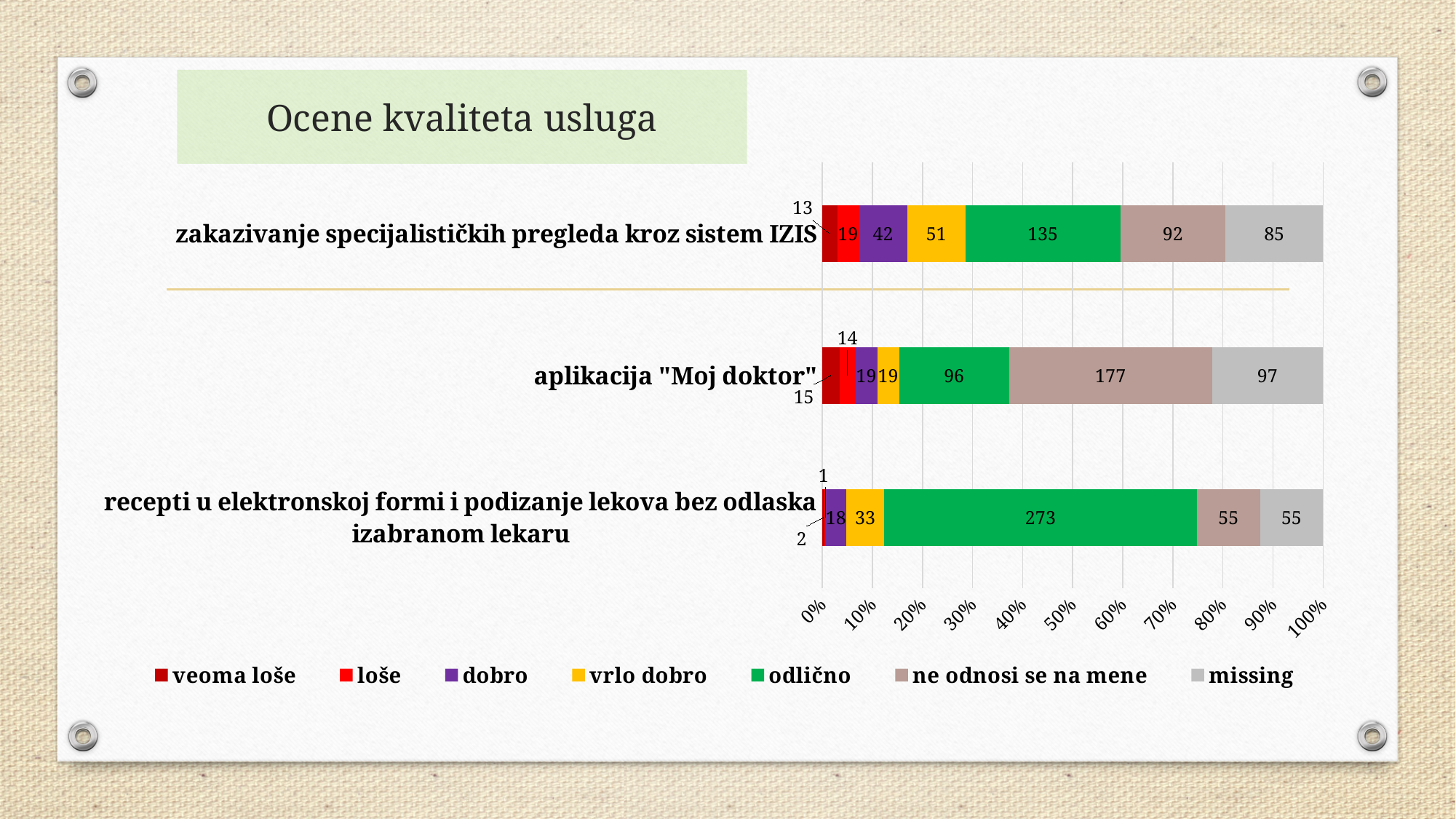
How many series does the legend list? 7 What is the difference between the "odlično" values for "zakazivanje specijalističkih pregleda kroz sistem IZIS" and "aplikacija "Moj doktor""? 39 What is the value of "vrlo dobro" for "zakazivanje specijalističkih pregleda kroz sistem IZIS"? 51 Which is larger: "ne odnosi se na mene" for "aplikacija "Moj doktor"" or for "zakazivanje specijalističkih pregleda kroz sistem IZIS"? aplikacija "Moj doktor" What kind of chart is shown on the slide? stacked bar chart Which category has the highest value for "odlično"? recepti u elektronskoj formi i podizanje lekova bez odlaska izabranom lekaru How many categories (bars) are shown in the chart? 3 What is the value of "ne odnosi se na mene" for "aplikacija "Moj doktor""? 177 What is the value of "missing" for "aplikacija "Moj doktor""? 97 Which category has the lowest value for "dobro"? recepti u elektronskoj formi i podizanje lekova bez odlaska izabranom lekaru What is the value of "odlično" for "recepti u elektronskoj formi i podizanje lekova bez odlaska izabranom lekaru"? 273 What is the total of all segments in the bar for "recepti u elektronskoj formi i podizanje lekova bez odlaska izabranom lekaru"? 437